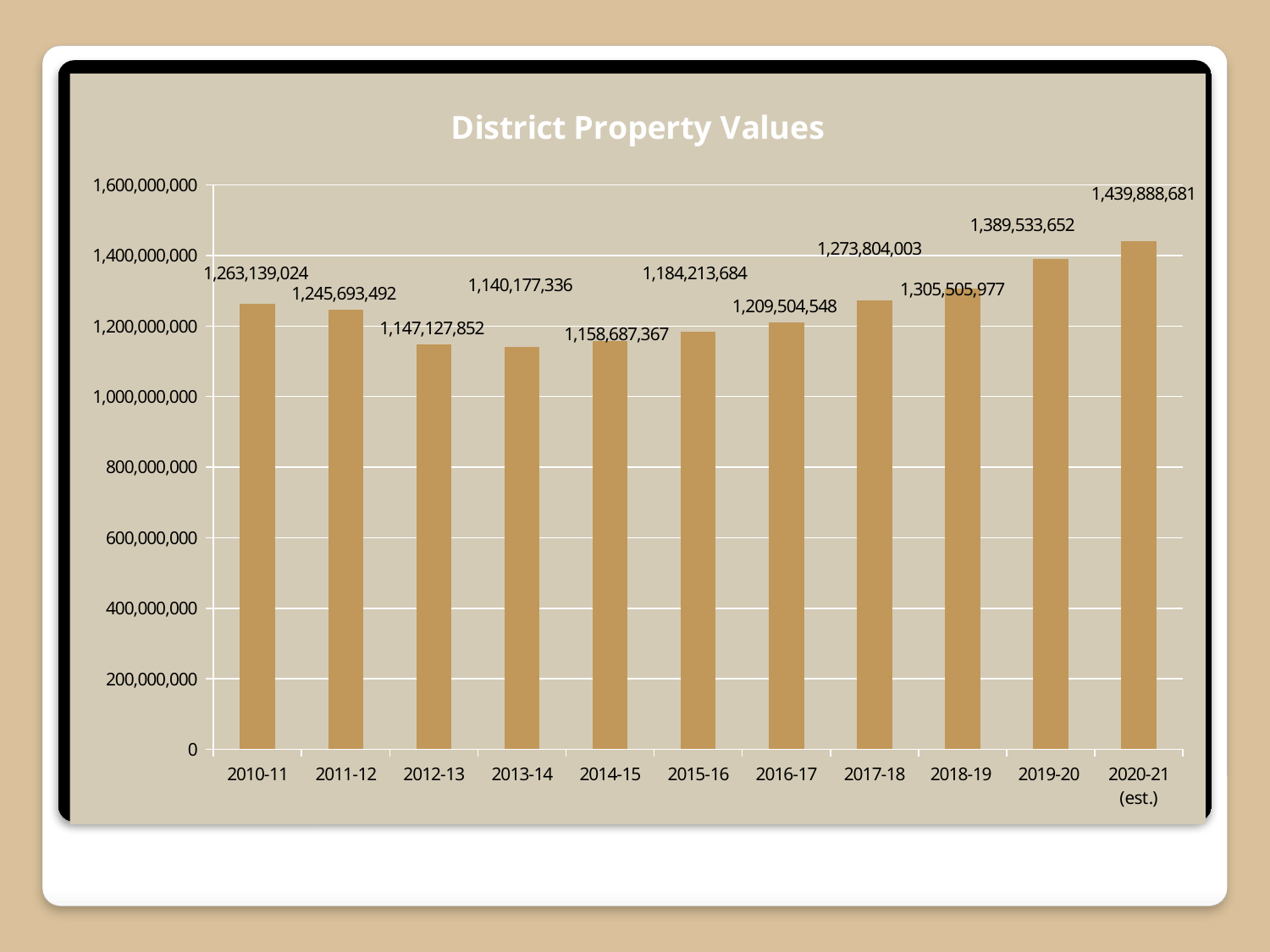
Which year has the highest district property value? 2020-21 (est.) Is the value for 2018-19 greater or less than 1,200,000,000? greater What is the difference between the 2010-11 and 2011-12 property values? 17,445,532 What is the district property value for 2015-16? 1,184,213,684 Which is larger, the property value for 2012-13 or for 2013-14? 2012-13 Do the district property values rise or fall from 2013-14 to 2020-21 (est.)? rise What is the estimated district property value for 2020-21? 1,439,888,681 By how much does the 2020-21 (est.) value exceed the 2019-20 value? 50,355,029 What kind of chart is shown on the slide? bar chart How many years are shown on the x axis? 11 What is the district property value for 2019-20? 1,389,533,652 Which year has the lowest district property value? 2013-14